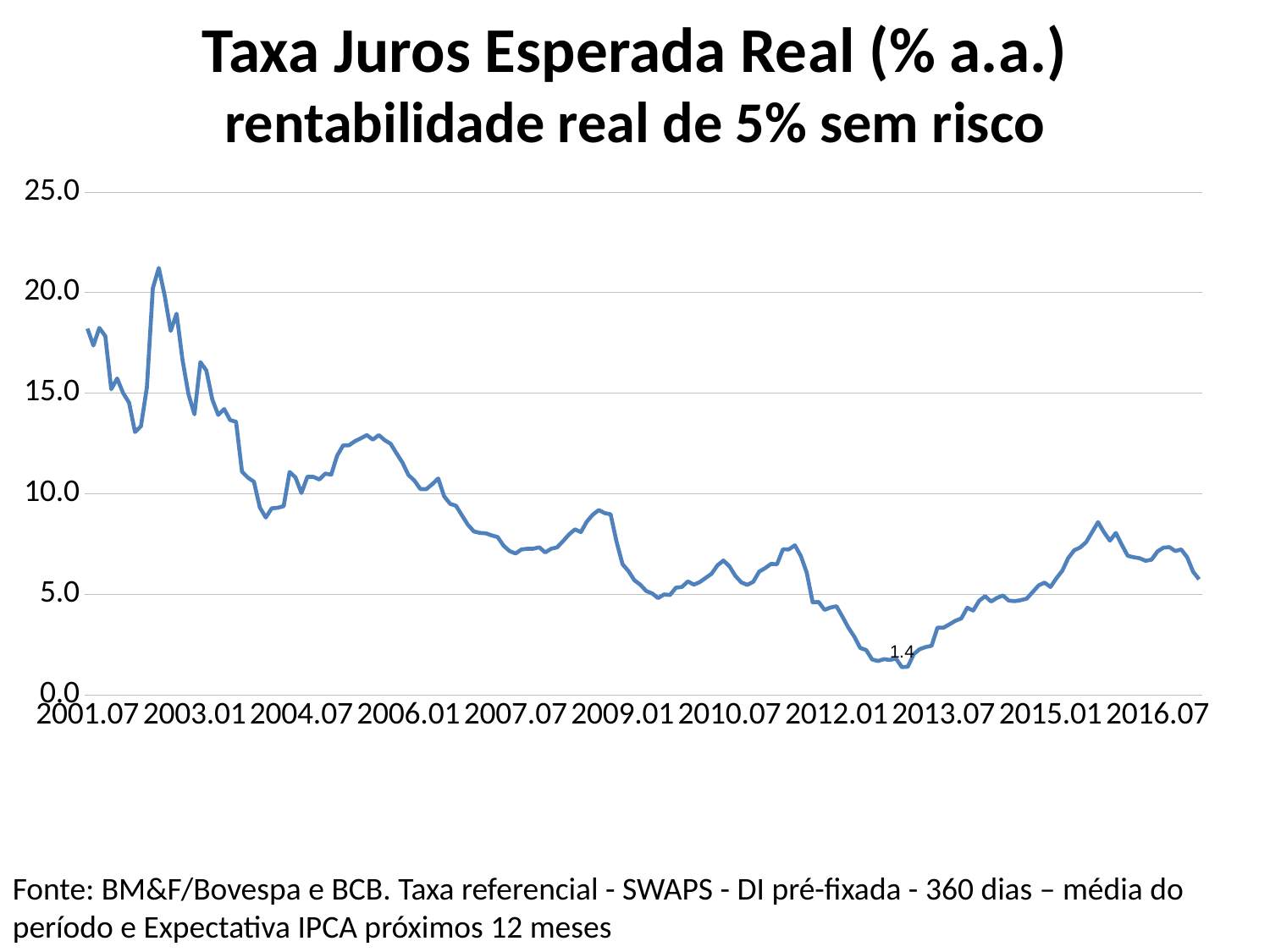
Is the value at 2006.01 greater or less than 15.0? less What is the lowest value labelled on the line? 1.4 Between which two x-axis labels does the line reach its lowest point? 2012.01 and 2013.07 Is the value at 2016.07 greater or less than 10.0? less Is the highest value reached by the line greater or less than 20.0? greater Which is larger, the value at 2004.07 or the value at 2013.07? 2004.07 What kind of chart is shown on the slide? line chart Which is larger, the value at 2001.07 or the value at 2016.07? 2001.07 Overall, does the line rise or fall from 2001.07 to 2016.07? fall How many labels are shown on the x axis? 11